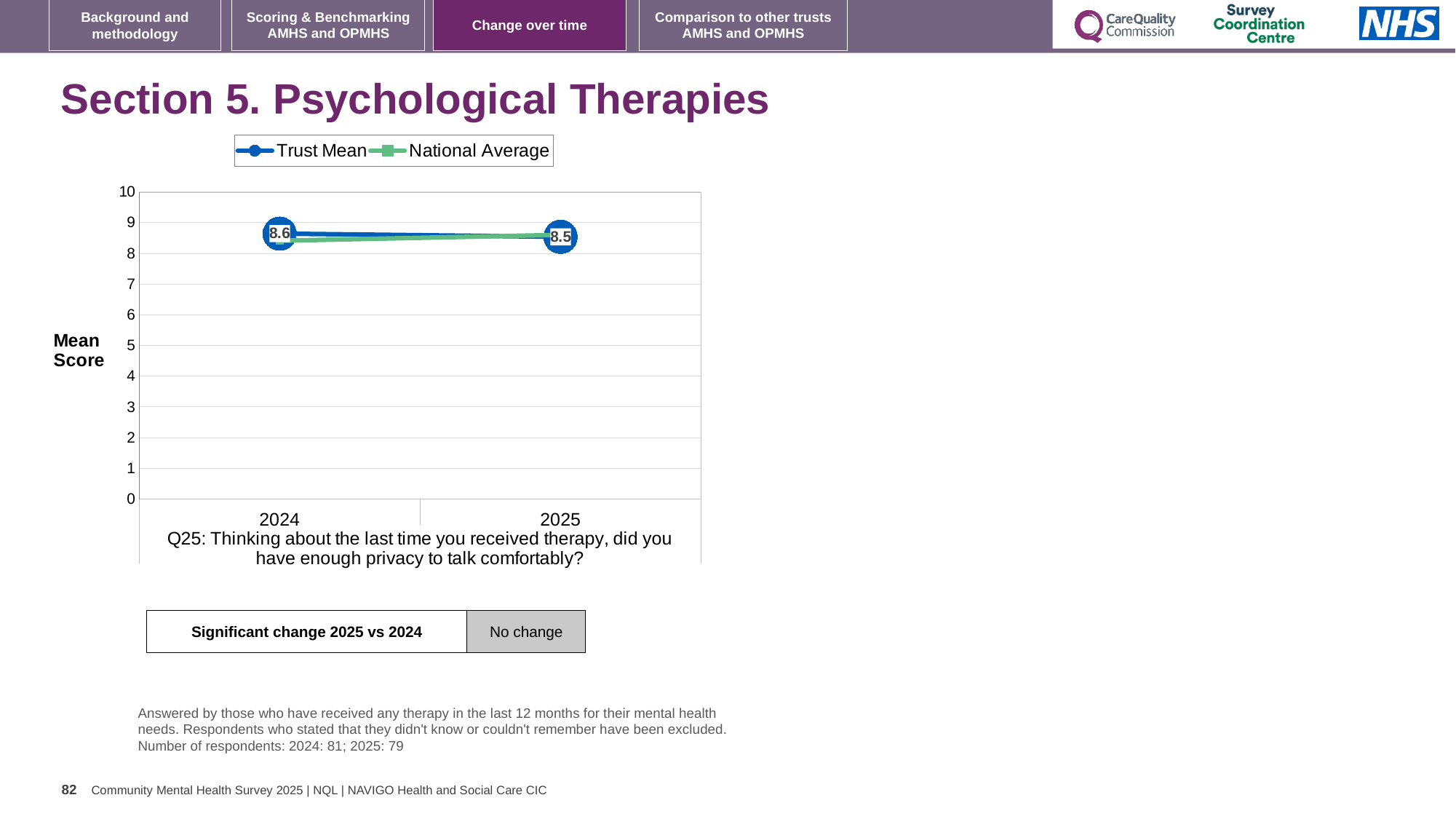
Is the National Average for 2025 greater or less than 7? greater What label is given to the y axis of the chart? Mean Score How many series does the chart legend list? 2 What is the difference between the Trust Mean in 2024 and in 2025? 0.1 What is the Trust Mean value for 2024? 8.6 What kind of chart is shown on the slide? Line chart Does the Trust Mean rise or fall from 2024 to 2025? Fall How many years are shown on the x axis of the chart? 2 In which year is the Trust Mean lowest? 2025 What is the Trust Mean value for 2025? 8.5 Is the Trust Mean for 2024 greater or less than 8? greater In which year is the Trust Mean higher, 2024 or 2025? 2024